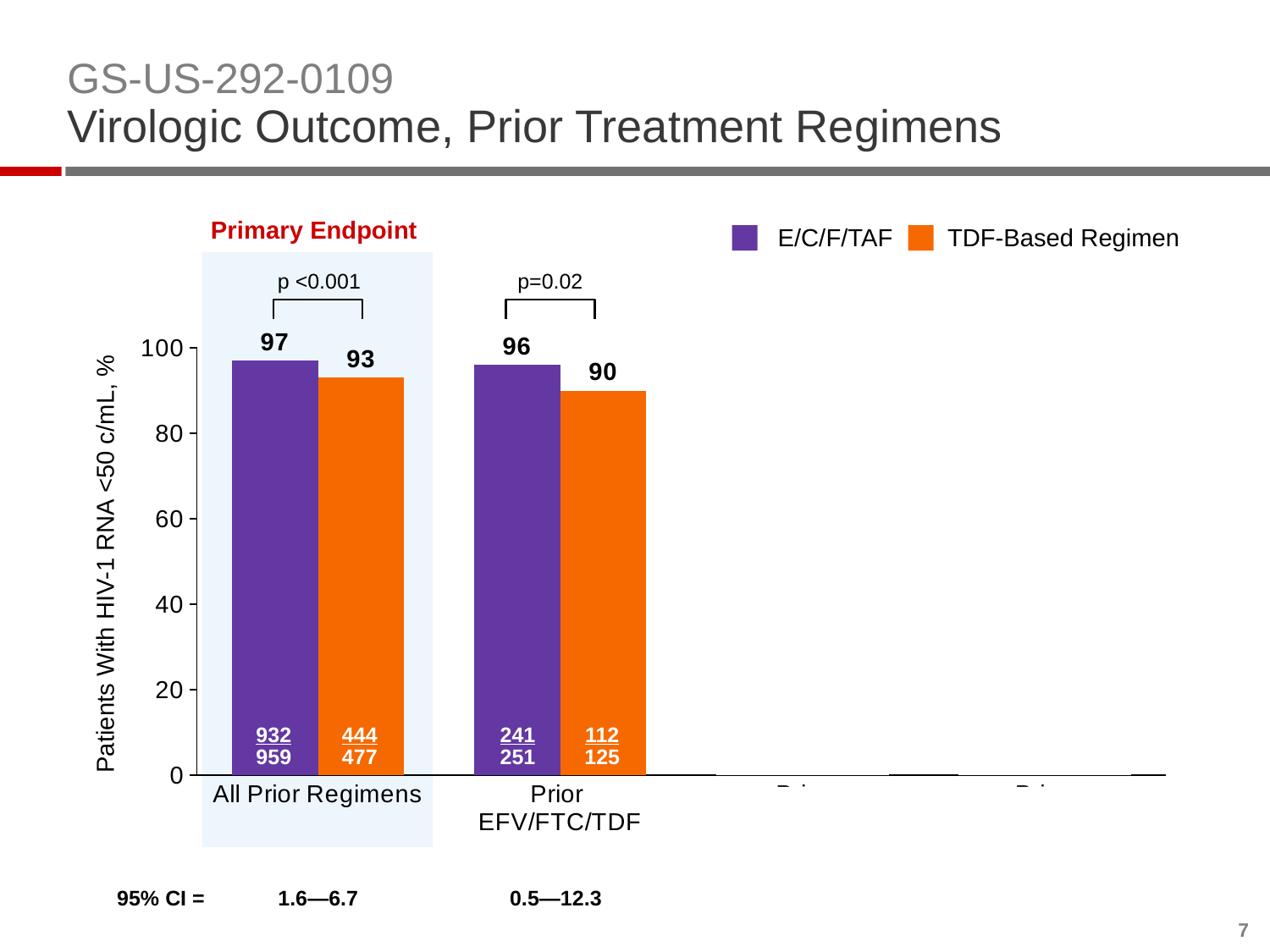
In the Prior EFV/FTC/TDF category, which series has the larger value, E/C/F/TAF or TDF-Based Regimen? E/C/F/TAF What is the difference between the E/C/F/TAF and TDF-Based Regimen values in the All Prior Regimens category? 4 Is the value for TDF-Based Regimen in the Prior EFV/FTC/TDF category greater or less than 80? greater What is the value for E/C/F/TAF in the Prior EFV/FTC/TDF category? 96 What is the difference between the E/C/F/TAF and TDF-Based Regimen values in the Prior EFV/FTC/TDF category? 6 Which bar on the chart has the lowest value? TDF-Based Regimen, Prior EFV/FTC/TDF What is the value for E/C/F/TAF in the All Prior Regimens category? 97 What kind of chart is shown on the slide? bar chart What is the p-value shown above the All Prior Regimens bars? p <0.001 What is the value for TDF-Based Regimen in the All Prior Regimens category? 93 How many series does the legend list? 2 What is the value for TDF-Based Regimen in the Prior EFV/FTC/TDF category? 90